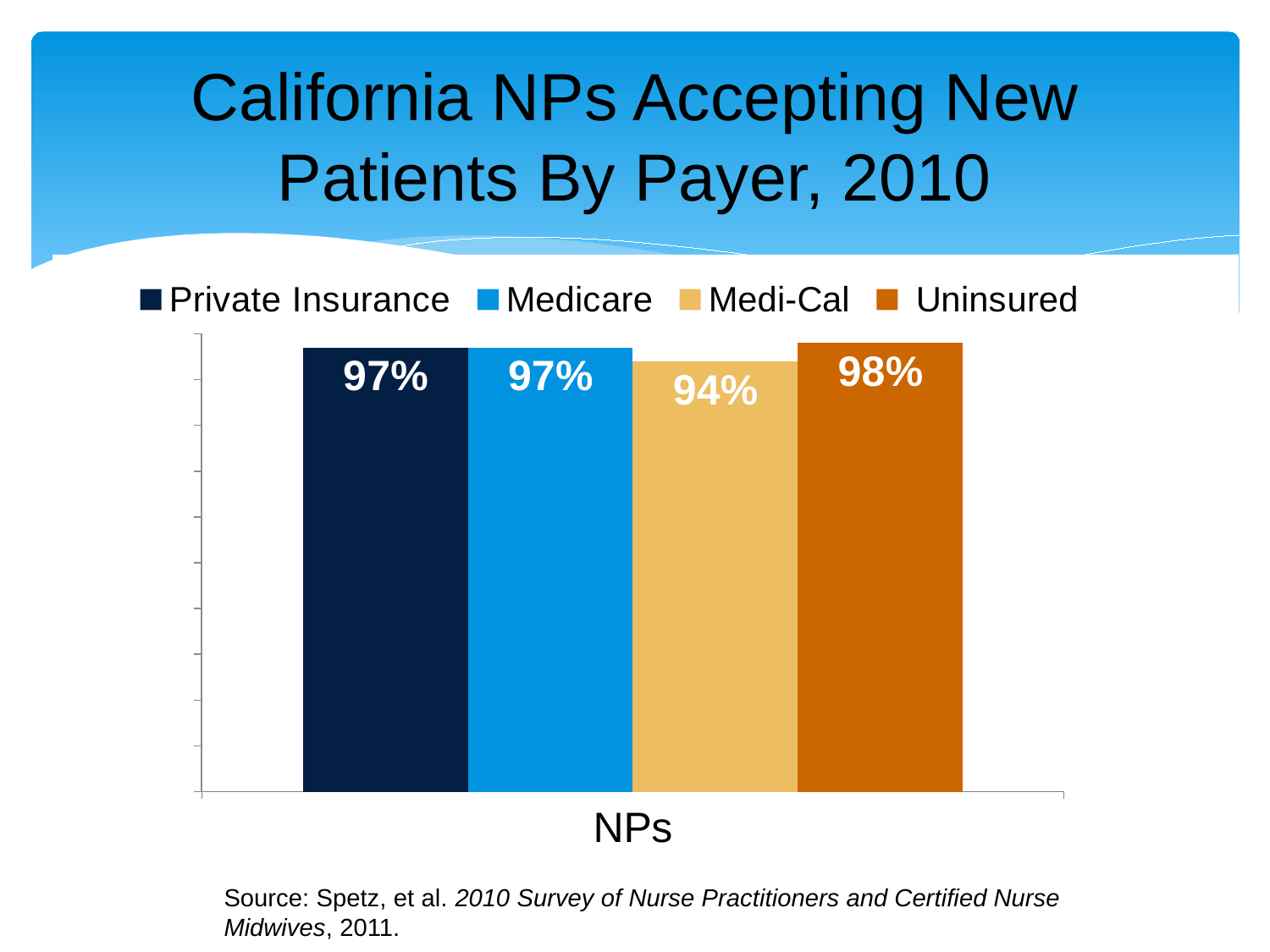
What percentage of California NPs accept new Medicare patients? 97% Which payer has the highest percentage of NPs accepting new patients? Uninsured What is the title of the chart on the slide? California NPs Accepting New Patients By Payer, 2010 What percentage of California NPs accept new Uninsured patients? 98% What kind of chart is shown on the slide? Bar chart What is the difference in percentage points between Uninsured and Medi-Cal? 4 Which is larger, the value for Medicare or the value for Medi-Cal? Medicare How many series does the legend list? 4 Which payer has the lowest percentage of NPs accepting new patients? Medi-Cal What percentage of California NPs accept new patients with Private Insurance? 97% What percentage of California NPs accept new Medi-Cal patients? 94% What is the difference in percentage points between Private Insurance and Medi-Cal? 3